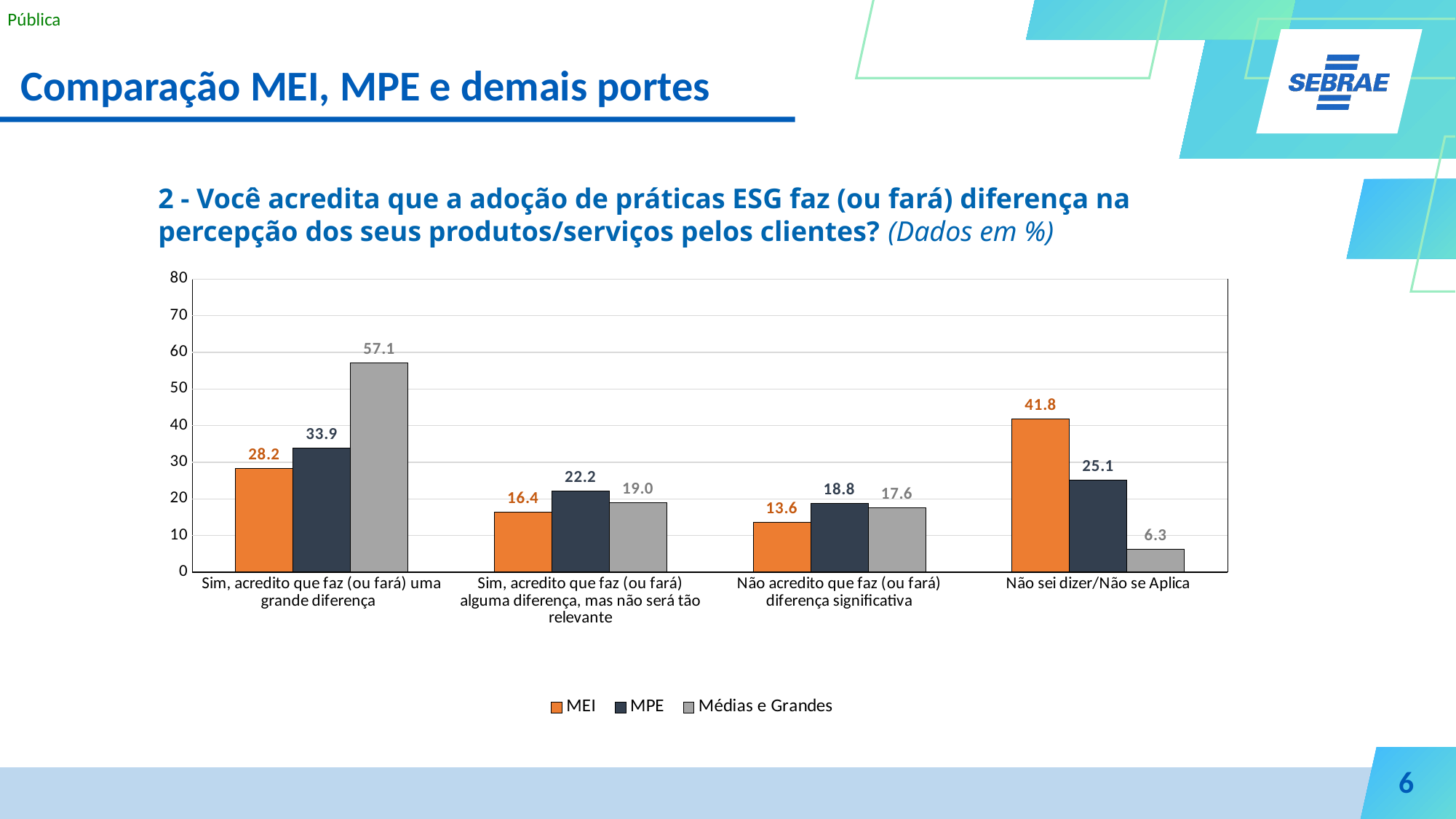
Is the value for Médias e Grandes in "Sim, acredito que faz (ou fará) uma grande diferença" greater or less than 50? greater What is the value for MEI in the category "Não sei dizer/Não se Aplica"? 41.8 Which category has the lowest value for the Médias e Grandes series? Não sei dizer/Não se Aplica Which category has the highest value for the MEI series? Não sei dizer/Não se Aplica What is the value for Médias e Grandes in the category "Sim, acredito que faz (ou fará) uma grande diferença"? 57.1 How many series does the legend list? 3 What kind of chart is shown on the slide? Bar chart What is the difference between the MPE and MEI values in the category "Sim, acredito que faz (ou fará) uma grande diferença"? 5.7 Which series is shown in orange in the legend? MEI In the category "Sim, acredito que faz (ou fará) alguma diferença, mas não será tão relevante", which series has the larger value: MPE or Médias e Grandes? MPE How many categories are shown on the x axis? 4 What is the value for MPE in the category "Não acredito que faz (ou fará) diferença significativa"? 18.8